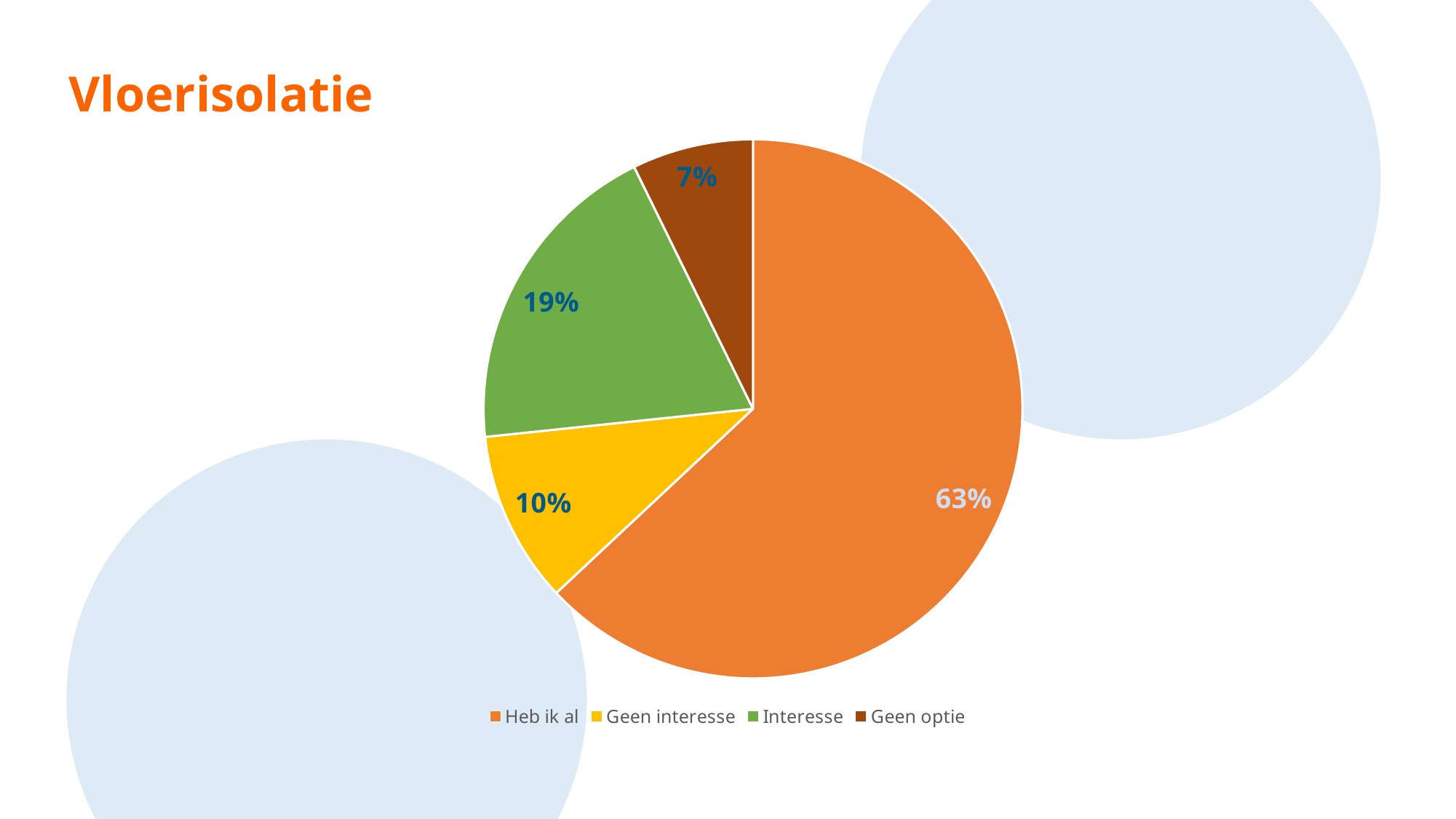
What kind of chart is shown on the slide? Pie chart Which category has the smallest slice of the pie? Geen optie What is the value shown for "Geen interesse"? 10% Which is larger, the share for "Geen interesse" or the share for "Geen optie"? Geen interesse What is the title of the slide? Vloerisolatie What share of the pie does "Interesse" represent? 19% Which category has the largest slice of the pie? Heb ik al How many categories does the pie chart show? 4 What is the difference between the shares of "Heb ik al" and "Interesse"? 44% What is the difference between the shares of "Interesse" and "Geen interesse"? 9% What is the value shown for "Geen optie"? 7% What share of the pie does "Heb ik al" represent? 63%